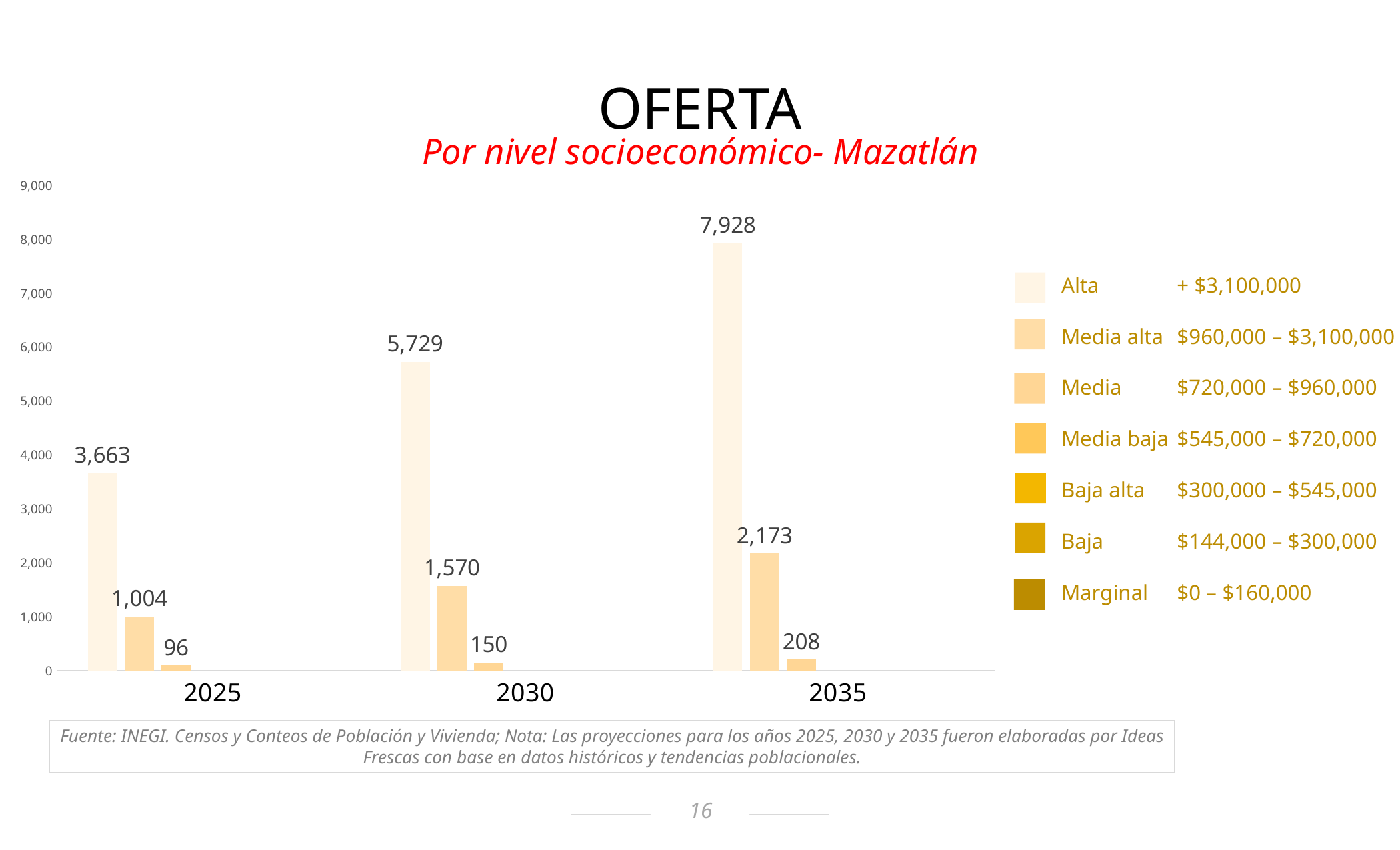
What is the difference between the Alta values for 2035 and 2030? 2,199 How many years are shown on the x axis? 3 In which year is the Alta value highest? 2035 Which is larger: Media alta in 2030 or Media alta in 2035? Media alta in 2035 In which year is the Media value lowest? 2025 Is the value for Alta in 2030 greater or less than 5,000? greater What is the value for Media alta in 2025? 1,004 What is the value for Media in 2030? 150 How many series does the legend list? 7 What is the value for Alta in 2035? 7,928 What kind of chart is shown on the slide? bar chart What is the difference between the Media alta values for 2035 and 2025? 1,169